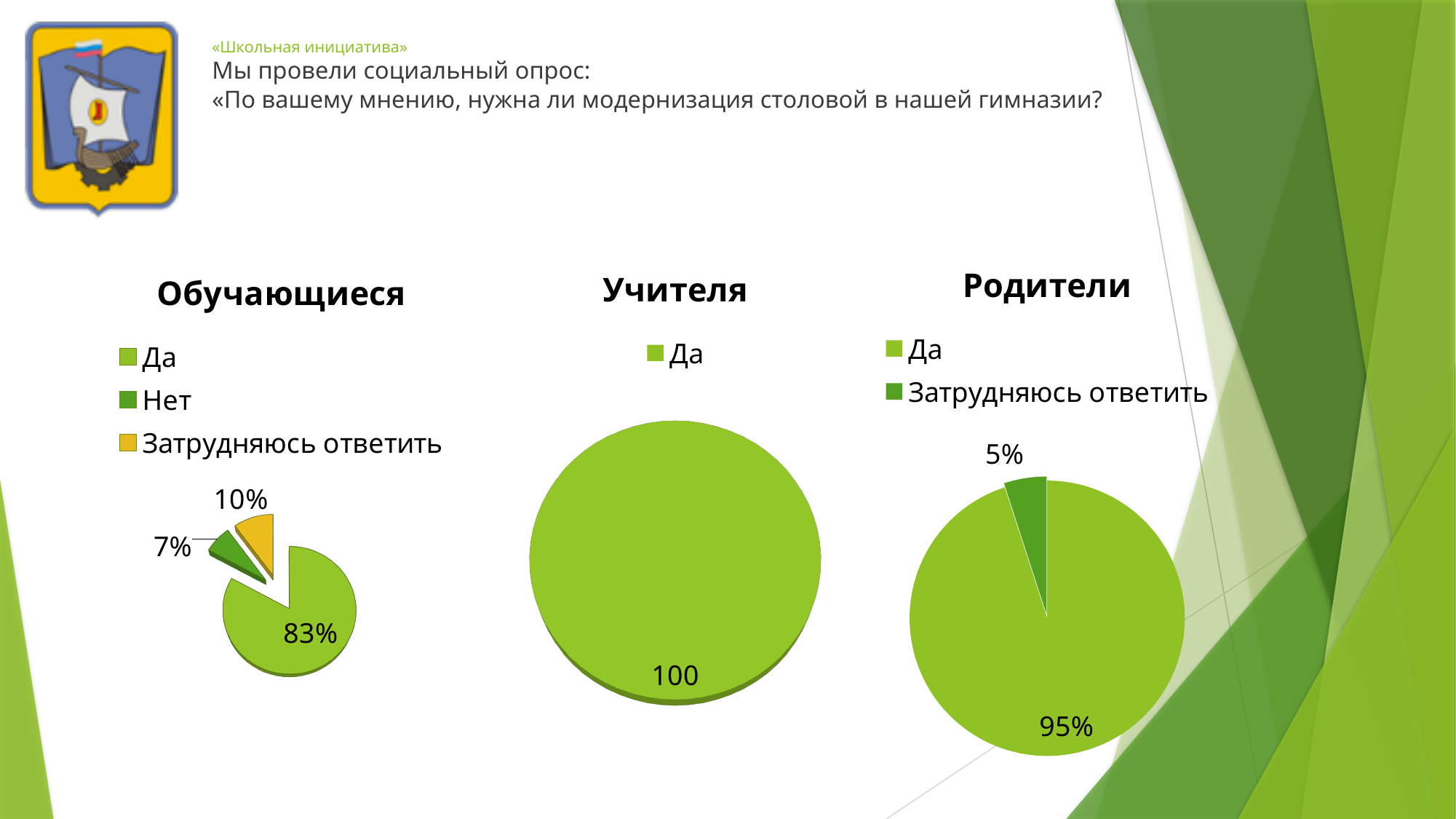
In the "Обучающиеся" chart, what share of respondents answered "Затрудняюсь ответить"? 10% In the "Родители" chart, what share of respondents answered "Да"? 95% In the "Обучающиеся" chart, what is the difference between the "Затрудняюсь ответить" share and the "Нет" share? 3% In the "Обучающиеся" chart, which answer has the smallest share? Нет How many categories does the legend of the "Учителя" chart list? 1 In the "Обучающиеся" chart, what share of respondents answered "Да"? 83% In the "Обучающиеся" chart, what share of respondents answered "Нет"? 7% What type of chart is used for the "Родители" data? Pie chart In the "Обучающиеся" chart, how many categories does the legend list? 3 Which is larger: the "Да" share in the "Обучающиеся" chart or the "Да" share in the "Родители" chart? Родители What value is printed on the "Учителя" chart? 100 In the "Родители" chart, what share of respondents answered "Затрудняюсь ответить"? 5%